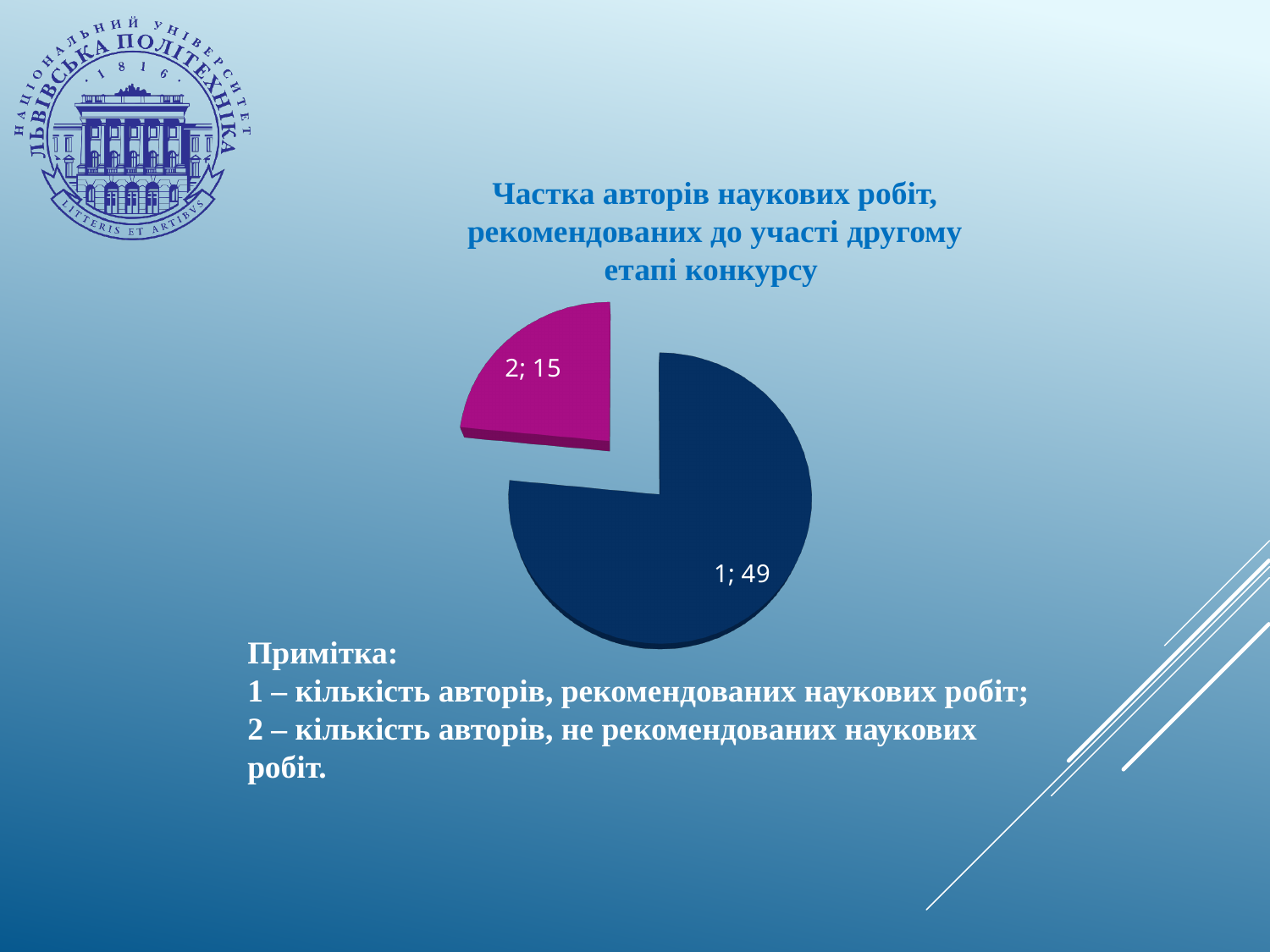
What is the total of the two values shown in the pie chart? 64 Which is larger, the value for category 1 or category 2? 1 What is the title of the pie chart? Частка авторів наукових робіт, рекомендованих до участі другому етапі конкурсу What is the value for category 1 in the pie chart? 49 What kind of chart is shown on the slide? pie chart Which category has the largest slice in the pie chart? 1 What colour is the slice for category 2? magenta What is the value for category 2 in the pie chart? 15 What is the difference between the values for category 1 and category 2? 34 How many slices does the pie chart have? 2 Which category has the smallest slice in the pie chart? 2